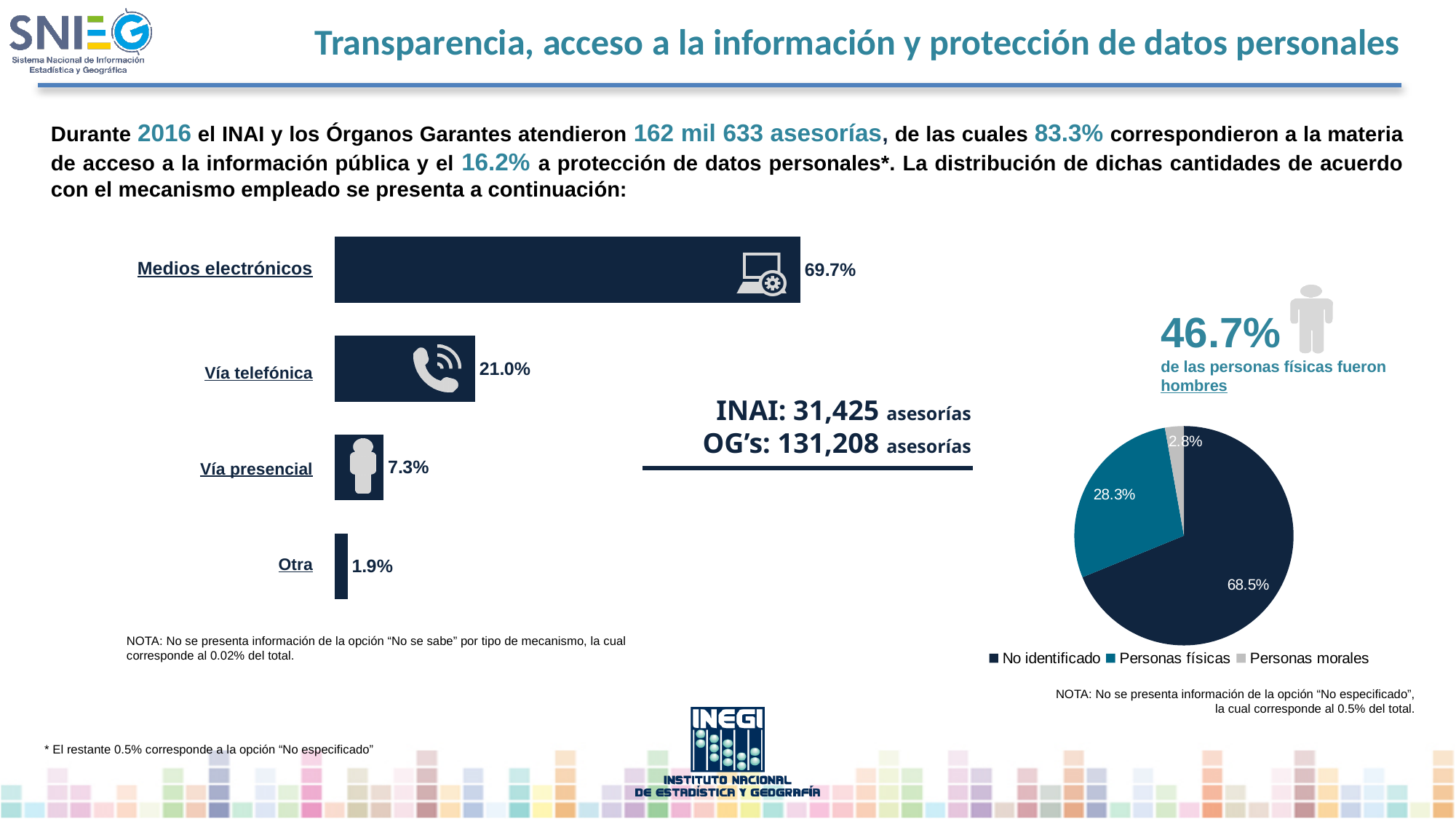
In the bar chart on the left, what is the value for Vía telefónica? 21.0% In the pie chart on the right, what is the share for Personas físicas? 28.3% In the pie chart on the right, what is the share for No identificado? 68.5% In the bar chart on the left, how many categories are shown? 4 In the bar chart on the left, what is the difference between Vía telefónica and Vía presencial? 13.7% In the pie chart on the right, which slice is the smallest? Personas morales In the bar chart on the left, which category has the lowest value? Otra In the pie chart on the right, which is larger: Personas físicas or Personas morales? Personas físicas In the bar chart on the left, what is the value for Medios electrónicos? 69.7% How many entries does the legend of the pie chart on the right list? 3 In the bar chart on the left, which category has the highest value? Medios electrónicos What kind of chart is the chart on the left? bar chart